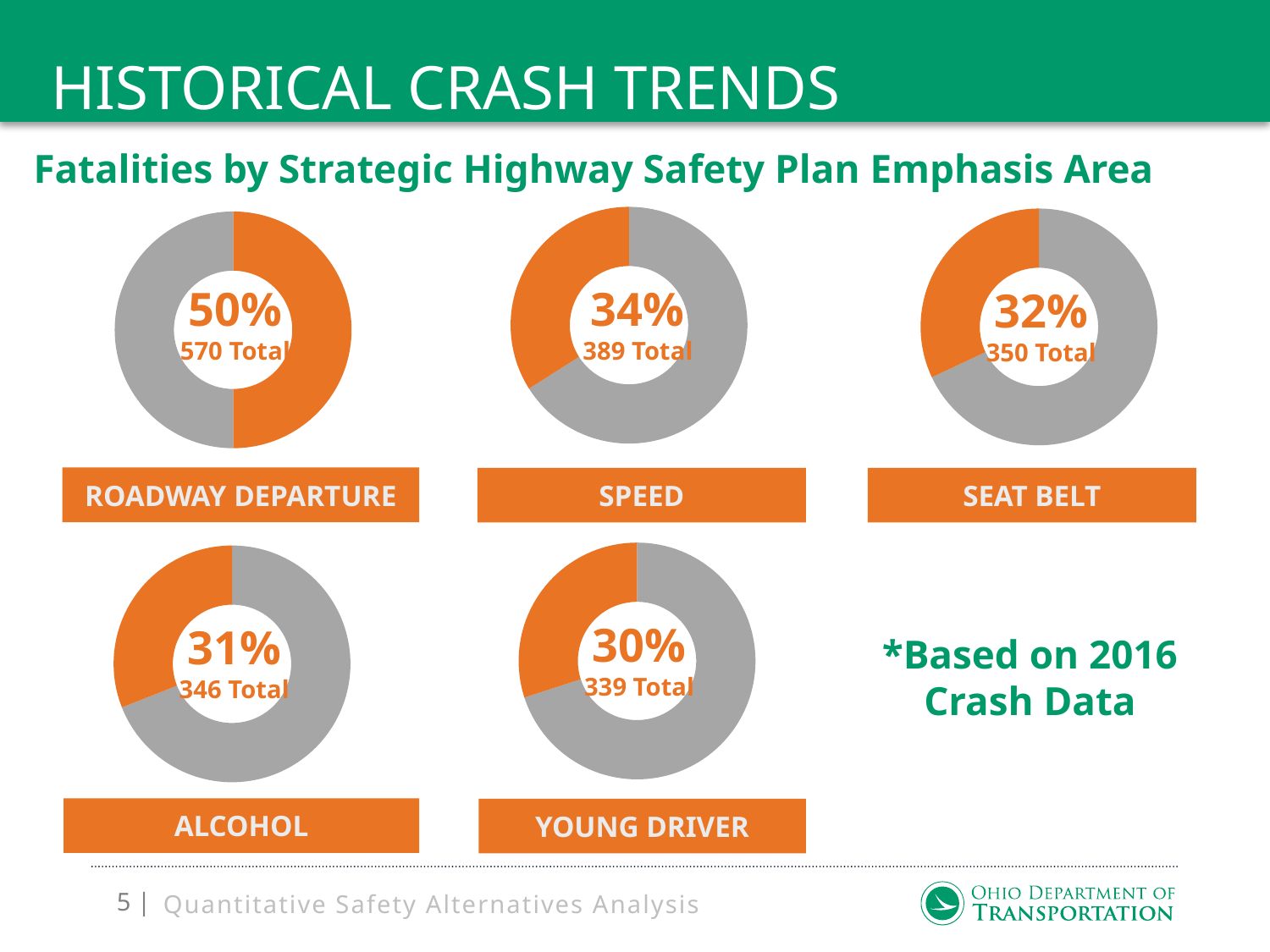
What total is shown in the Speed chart? 389 Total What total is shown in the Alcohol chart? 346 Total What kind of chart is used for each emphasis area on the slide? Donut (pie) chart Which emphasis area chart shows the lowest percentage of fatalities? Young Driver What is the difference in total fatalities between the Roadway Departure chart and the Speed chart? 181 Which has a larger total, the Seat Belt chart or the Alcohol chart? Seat Belt What percentage is shown in the Roadway Departure chart? 50% What year of crash data are the charts based on? 2016 How many donut charts are on the slide? 5 Which emphasis area chart shows the highest percentage of fatalities? Roadway Departure What percentage is shown in the Young Driver chart? 30% What percentage is shown in the Seat Belt chart? 32%